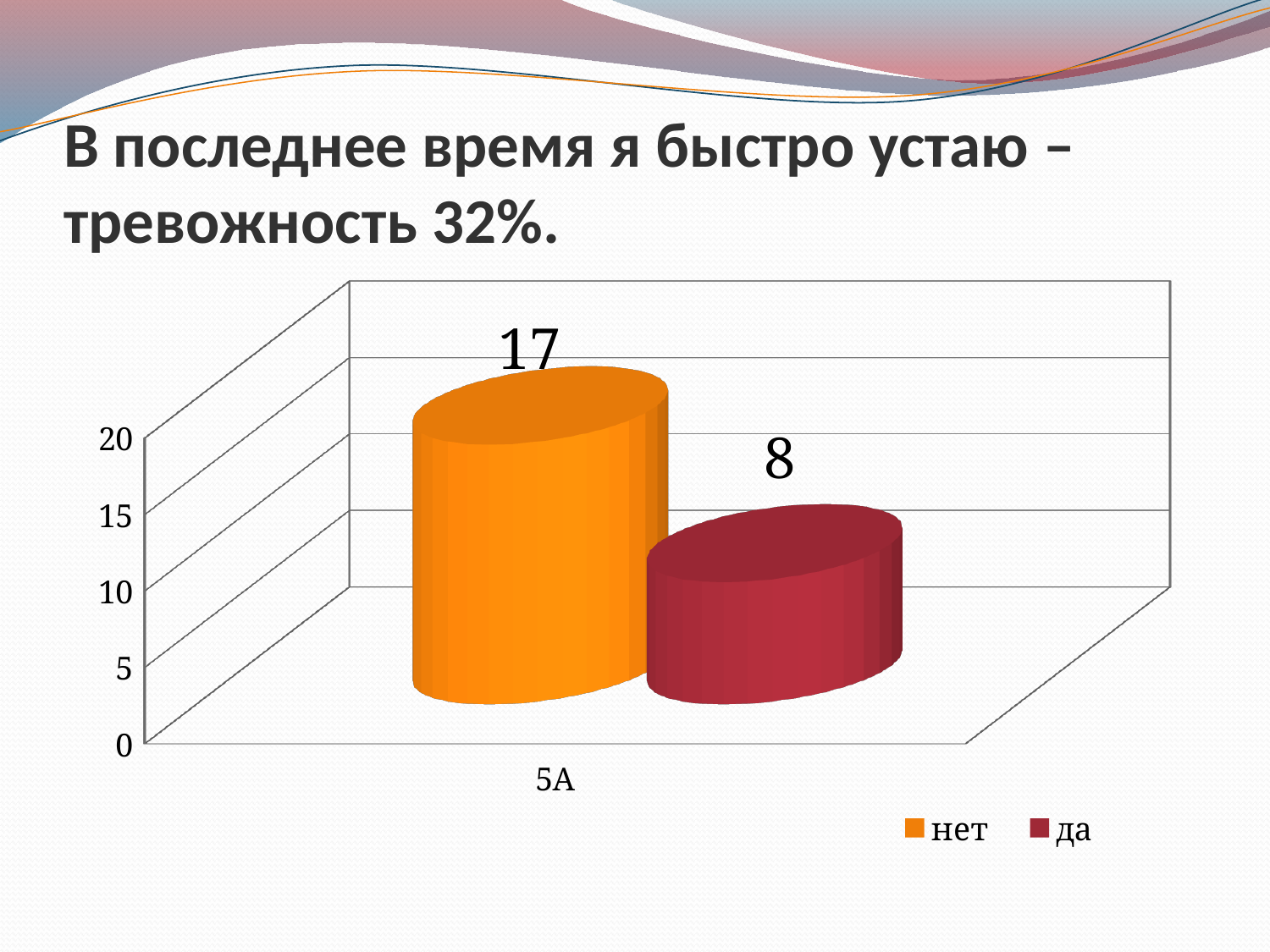
What is the category label on the x axis? 5А Which series has the higher value: "нет" or "да"? нет Which series has the lowest value on the chart? да What is the value for the series "да" in category 5А? 8 How many series does the legend list? 2 What colour represents the series "да" in the legend? dark red How many categories are shown on the x axis? 1 Is the value for "да" greater or less than 10? less Is the value for "нет" greater or less than 15? greater What is the difference between the values for "нет" and "да"? 9 What is the value for the series "нет" in category 5А? 17 What kind of chart is shown on the slide? bar chart